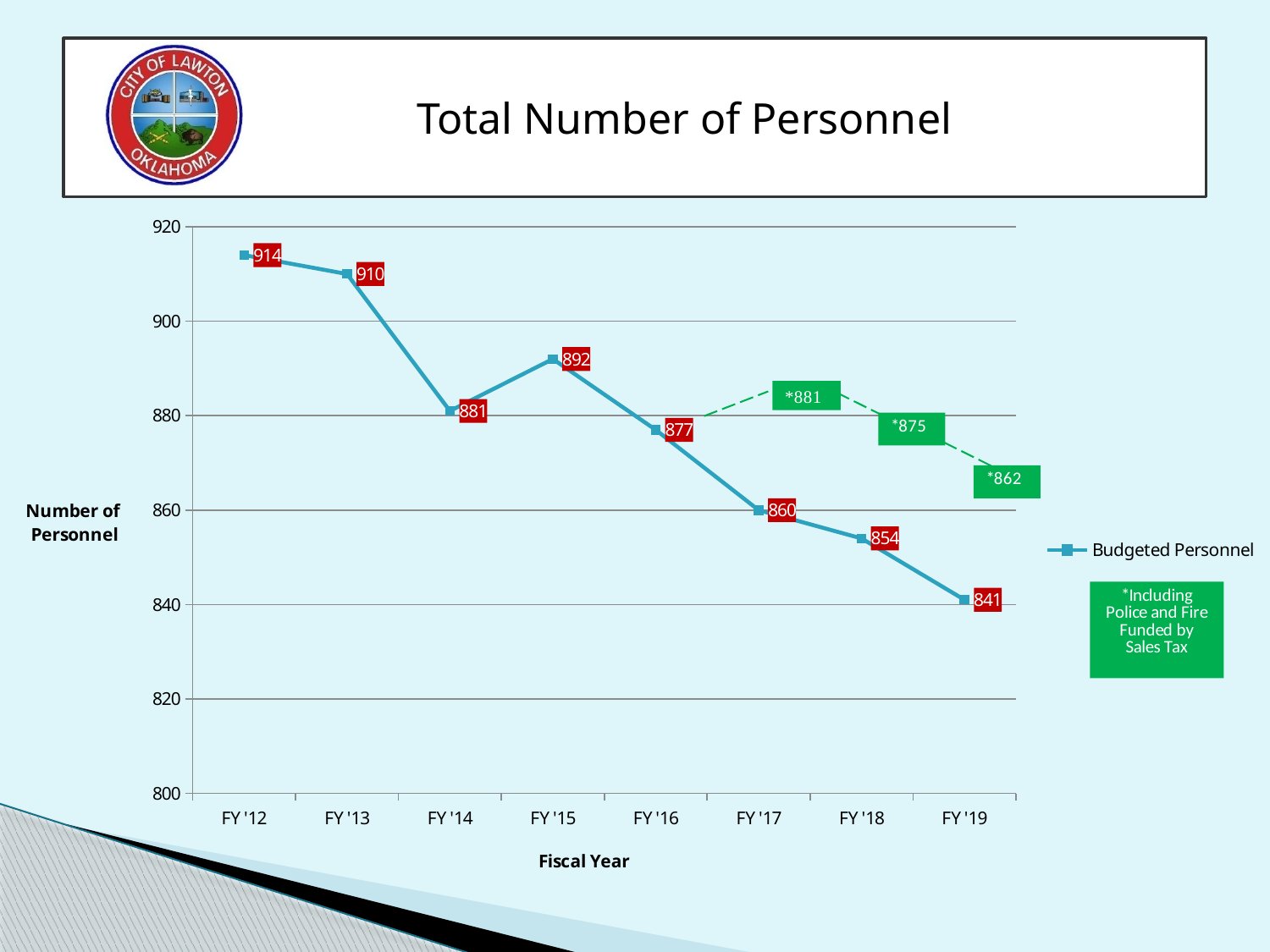
How many series does the legend list? 1 Which is larger, the budgeted personnel for FY '14 or FY '15? FY '15 What is the budgeted personnel value for FY '19? 841 How many fiscal years are shown on the x axis? 8 What kind of chart is shown? Line chart Which fiscal year has the highest budgeted personnel? FY '12 What is the budgeted personnel value for FY '12? 914 What is the budgeted personnel value for FY '15? 892 Which fiscal year has the lowest budgeted personnel? FY '19 What is the FY '18 value including Police and Fire funded by sales tax? *875 What is the difference in budgeted personnel between FY '12 and FY '19? 73 Do the budgeted personnel values generally rise or fall from FY '12 to FY '19? Fall